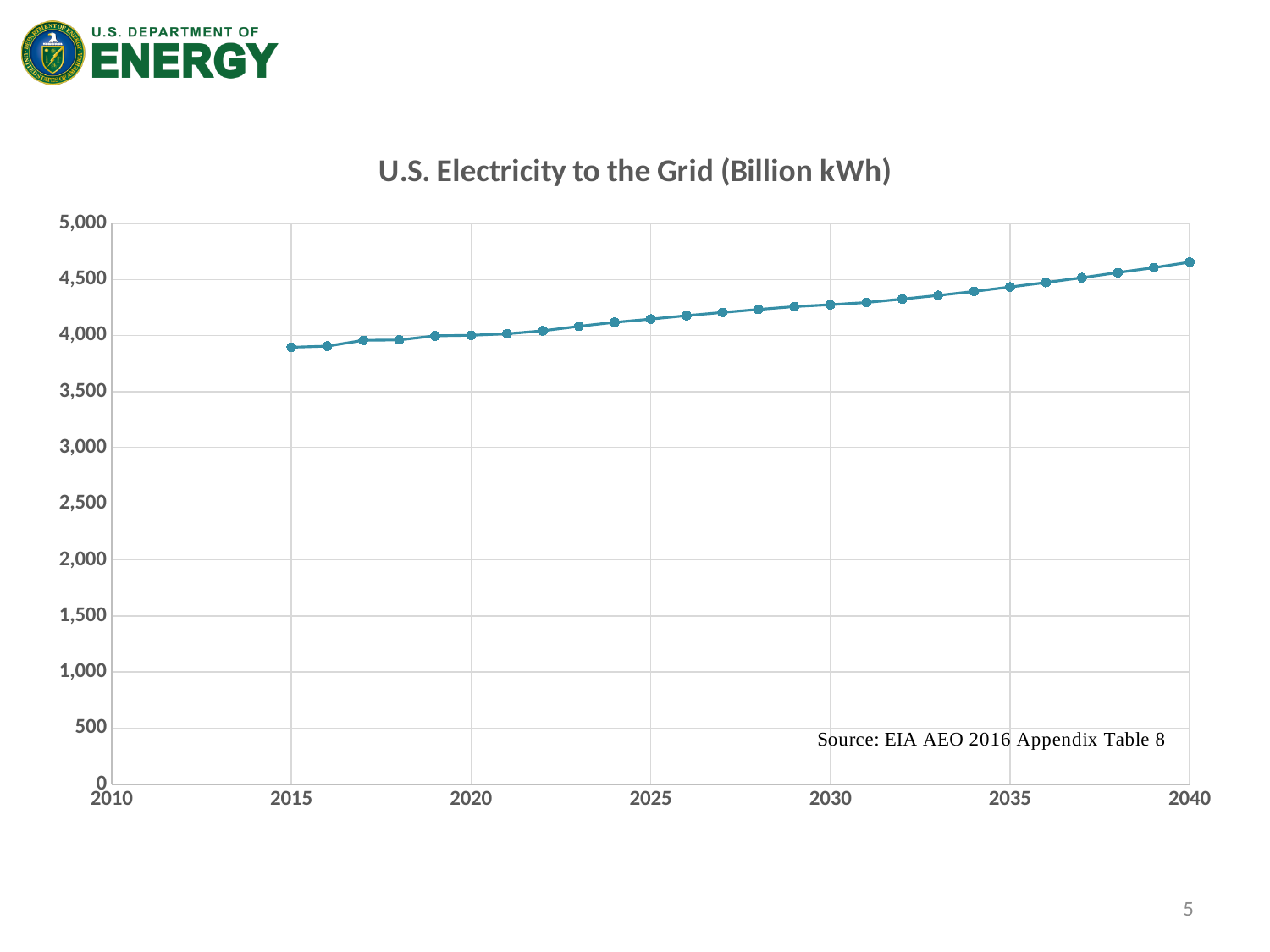
Do the values rise or fall from 2015 to 2040? Rise What source is cited on the chart? EIA AEO 2016 Appendix Table 8 What is the title of the chart? U.S. Electricity to the Grid (Billion kWh) How many data points are plotted on the line? 26 Which year has the highest value on the chart? 2040 Which year has the lowest value on the chart? 2015 Is the value for 2015 greater or less than 4,000? less What kind of chart is shown on the slide? Line chart Which is larger, the value for 2020 or the value for 2030? 2030 Is the value for 2035 greater or less than 4,500? less Is the value for 2040 greater or less than 4,500? greater